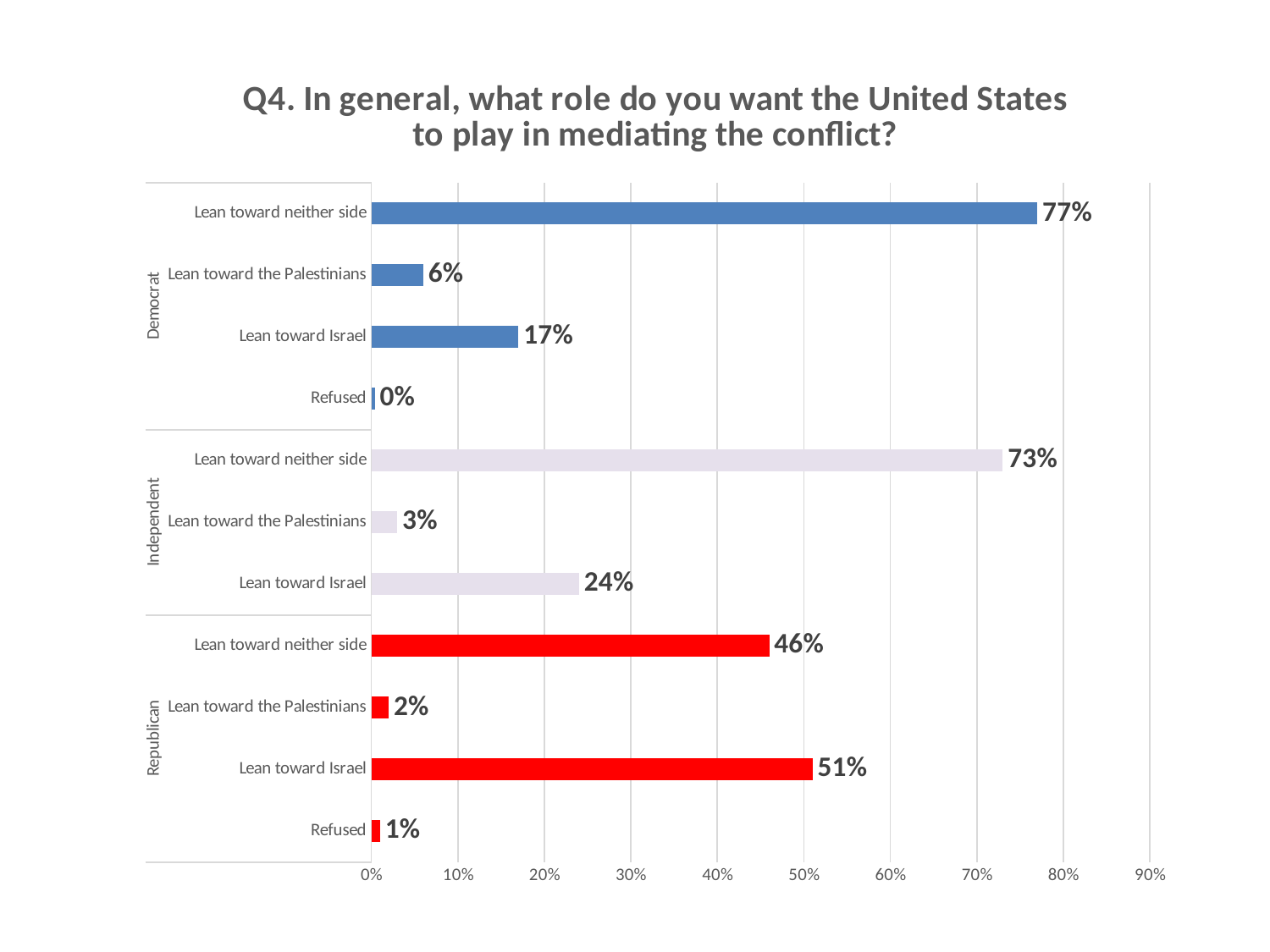
Is the Republican value for 'Lean toward neither side' greater or less than 50%? less What is the difference between the Republican values for 'Lean toward Israel' and 'Lean toward neither side'? 5% Which response has the highest value among Republicans? Lean toward Israel What percentage of Democrats want the United States to lean toward neither side? 77% What type of chart is shown on the slide? Bar chart What percentage of Independents want the United States to lean toward the Palestinians? 3% What colour are the bars for the Republican group? Red Which response has the lowest value among Democrats? Refused What is the difference between the Democrat and Independent values for 'Lean toward neither side'? 4% What percentage of Republicans want the United States to lean toward Israel? 51% How many bars are plotted in the chart? 11 Which is larger: the Independent value for 'Lean toward Israel' or the Democrat value for 'Lean toward Israel'? Independent